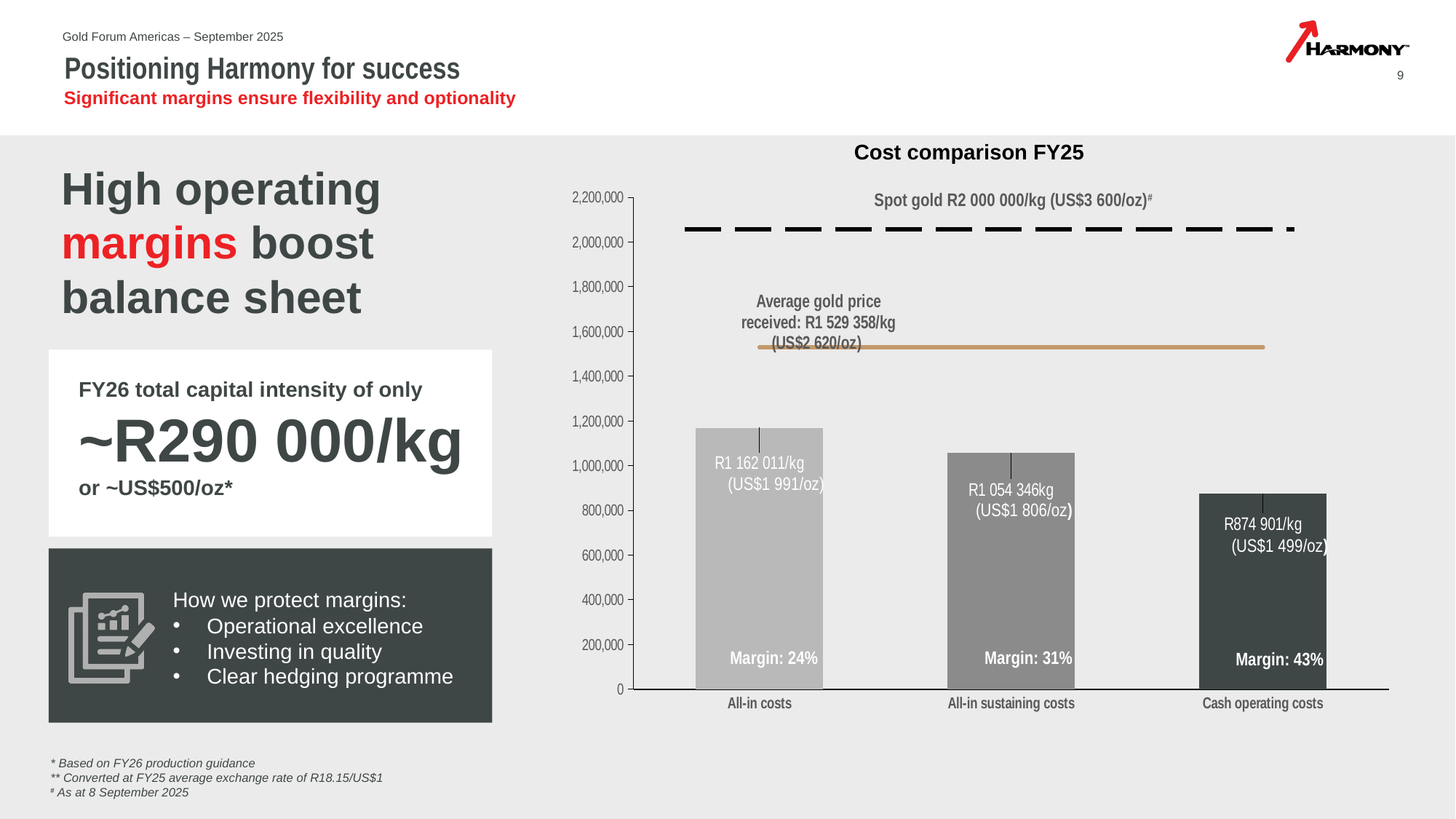
What is the US$/oz value shown for All-in sustaining costs? US$1 806/oz What is the difference in R/kg between All-in costs and Cash operating costs? R287 110/kg How many cost categories are plotted as bars in the chart? 3 What is the value shown for All-in costs in R/kg? R1 162 011/kg Is the value for All-in sustaining costs greater or less than 1,000,000? greater What type of chart is shown on the slide? Combination bar and line chart What is the title of the chart? Cost comparison FY25 What is the value shown for Cash operating costs in R/kg? R874 901/kg What margin is shown for Cash operating costs? 43% Which cost category has the highest bar? All-in costs What spot gold price in R/kg is shown by the dashed line? R2 000 000/kg Which cost category has the lowest bar? Cash operating costs